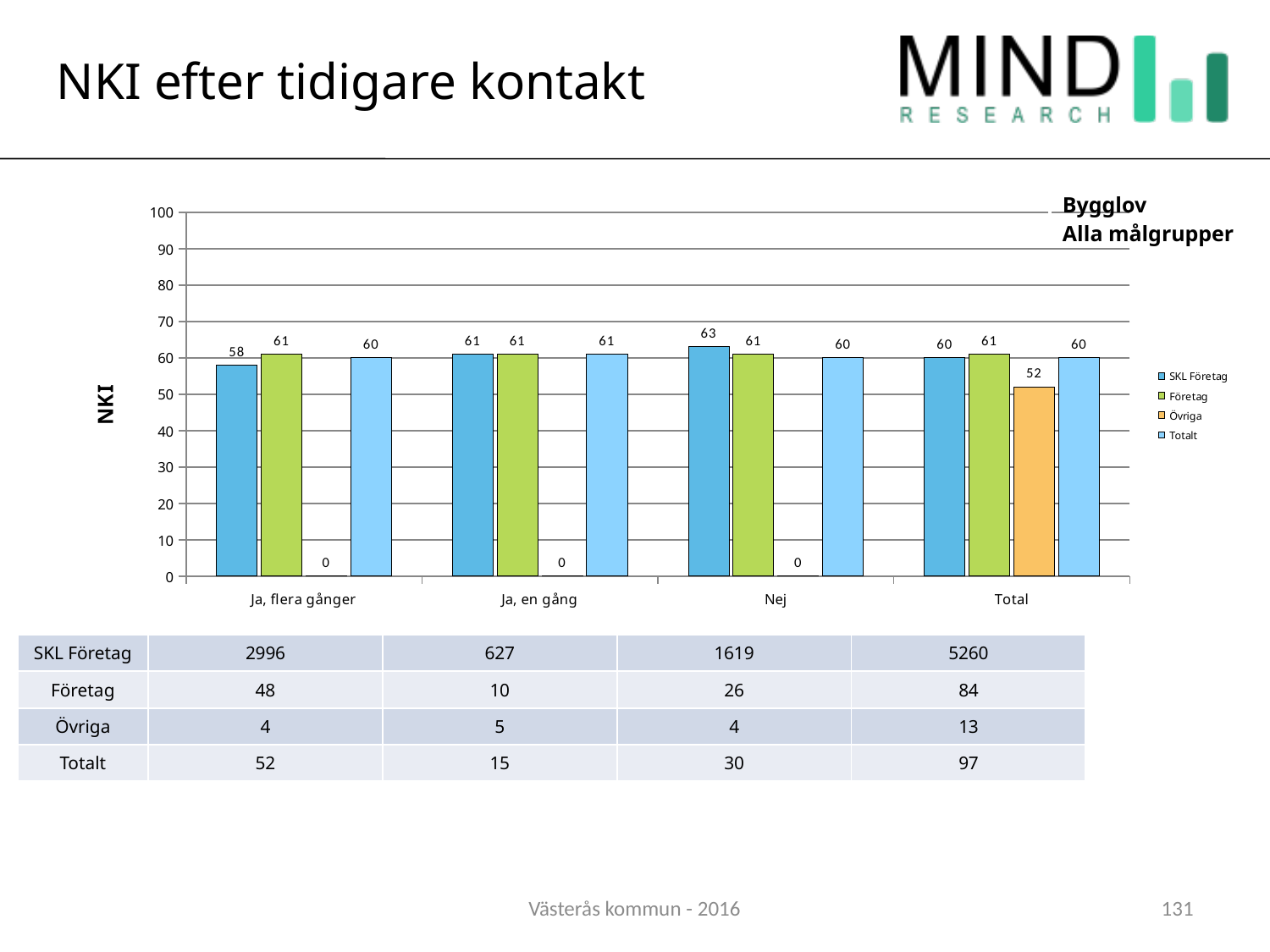
How many series does the chart legend list? 4 How many categories are shown on the x axis of the chart? 4 What kind of chart is shown on the slide? Bar chart What is the NKI value for SKL Företag in the 'Nej' category? 63 In which category does SKL Företag have its lowest NKI value? Ja, flera gånger What is the NKI value for SKL Företag in the 'Ja, flera gånger' category? 58 Which is larger in the 'Total' category: the Företag value or the Övriga value? Företag What is the NKI value for Totalt in the 'Ja, en gång' category? 61 What is the difference between the SKL Företag value for 'Nej' and for 'Ja, flera gånger'? 5 In which category does SKL Företag have its highest NKI value? Nej What is the label of the y axis of the chart? NKI What is the NKI value for Övriga in the 'Total' category? 52